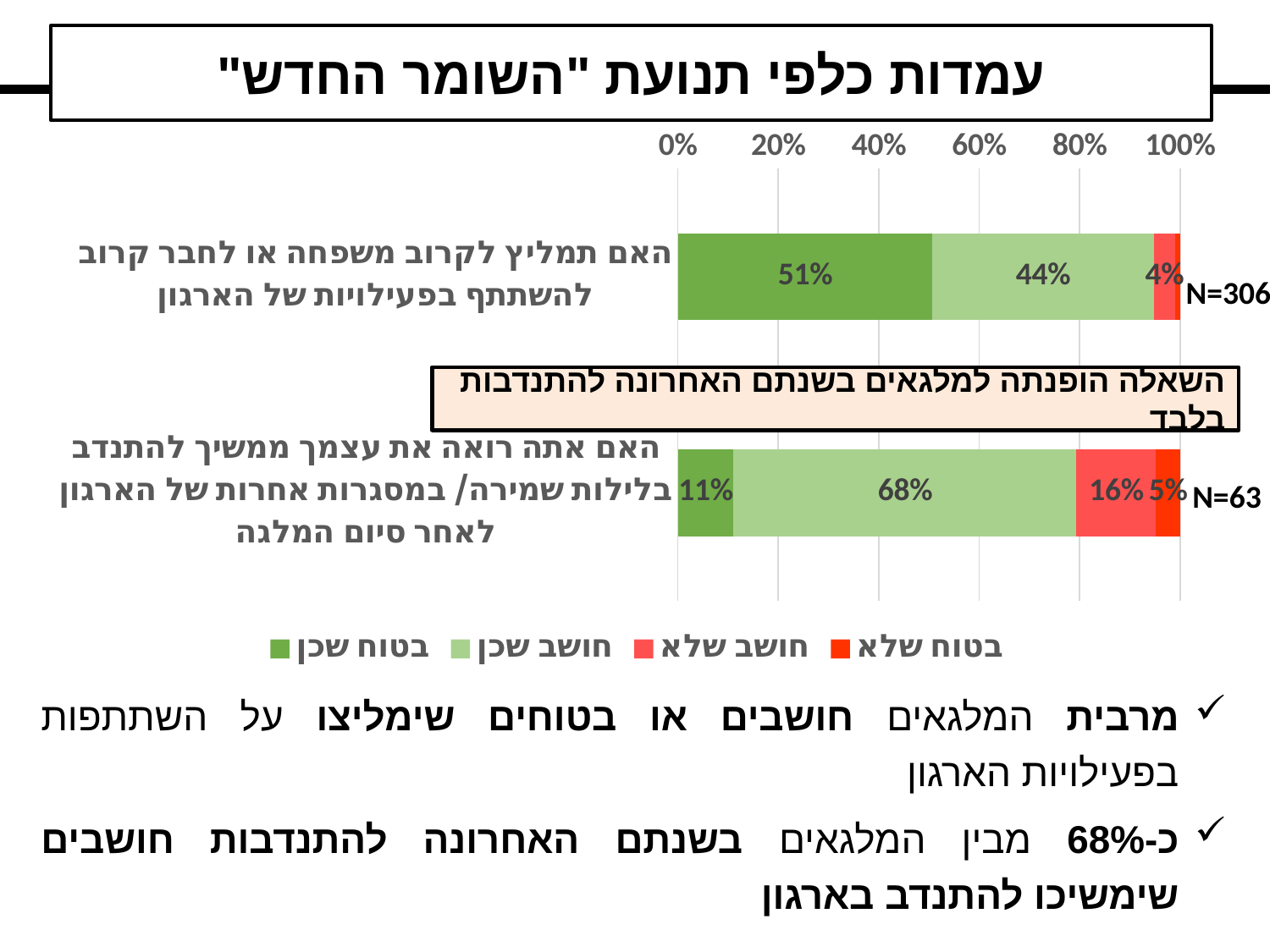
What is the difference between the "חושב שכן" share for continuing to volunteer (68%) and for recommending a relative/friend (44%)? 24 percentage points What is the sample size (N) shown for the question about recommending a relative or close friend? N=306 What percentage answered "בטוח שלא" to the question about continuing to volunteer after the scholarship ends? 5% What percentage answered "חושב שכן" to the question about continuing to volunteer after the scholarship ends? 68% How many questions (categories) are plotted in the chart? 2 How many series does the legend list? 4 What percentage answered "חושב שלא" to the question about continuing to volunteer after the scholarship ends? 16% What percentage answered "בטוח שכן" to the question about recommending a relative or close friend to participate in the organization's activities? 51% What kind of chart is shown on the slide? Stacked bar chart What is the title of the chart? עמדות כלפי תנועת "השומר החדש" What is the total of the labeled segments in the bar for continuing to volunteer after the scholarship ends (11%, 68%, 16%, 5%)? 100% Which question has the larger "בטוח שכן" share: recommending a relative/friend or continuing to volunteer after the scholarship? Recommending a relative/friend (51%)